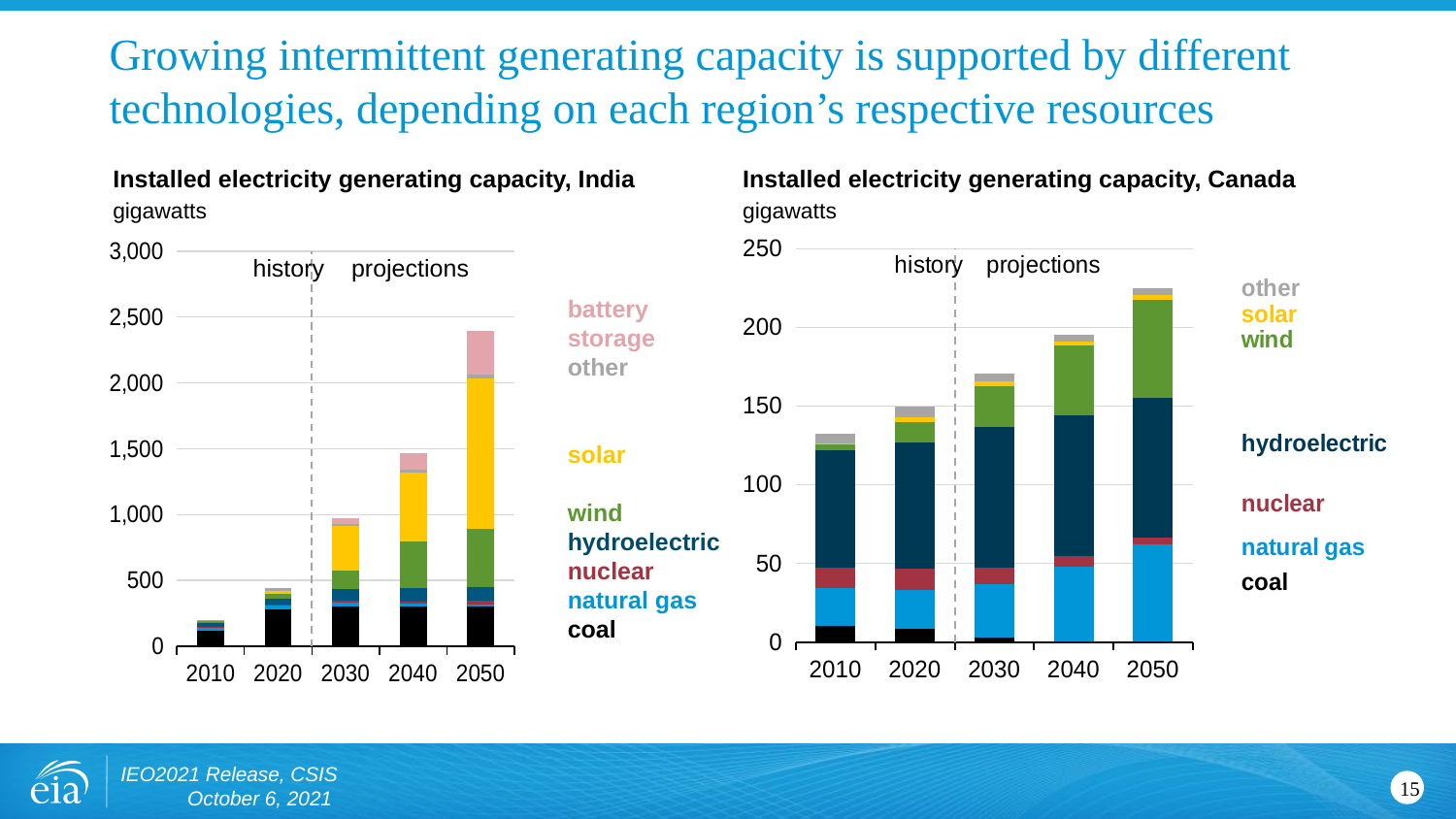
In the 'Installed electricity generating capacity, Canada' chart, do the total stacked bar heights rise or fall from 2010 to 2050? rise In the 'Installed electricity generating capacity, India' chart, which year has the shortest stacked bar? 2010 In the 'Installed electricity generating capacity, India' chart, is the total for 2050 greater or less than 2,000 gigawatts? greater What kind of chart is the 'Installed electricity generating capacity, India' chart? stacked bar chart How many series does the legend of the 'Installed electricity generating capacity, Canada' chart list? 7 In the 'Installed electricity generating capacity, India' chart, is the total for 2010 greater or less than 500 gigawatts? less In the 'Installed electricity generating capacity, India' chart, which year has the tallest stacked bar? 2050 In the 'Installed electricity generating capacity, Canada' chart, is the total for 2010 greater or less than 150 gigawatts? less What unit is given under the title of the 'Installed electricity generating capacity, Canada' chart? gigawatts How many years are shown on the x axis of the 'Installed electricity generating capacity, Canada' chart? 5 How many series does the legend of the 'Installed electricity generating capacity, India' chart list? 8